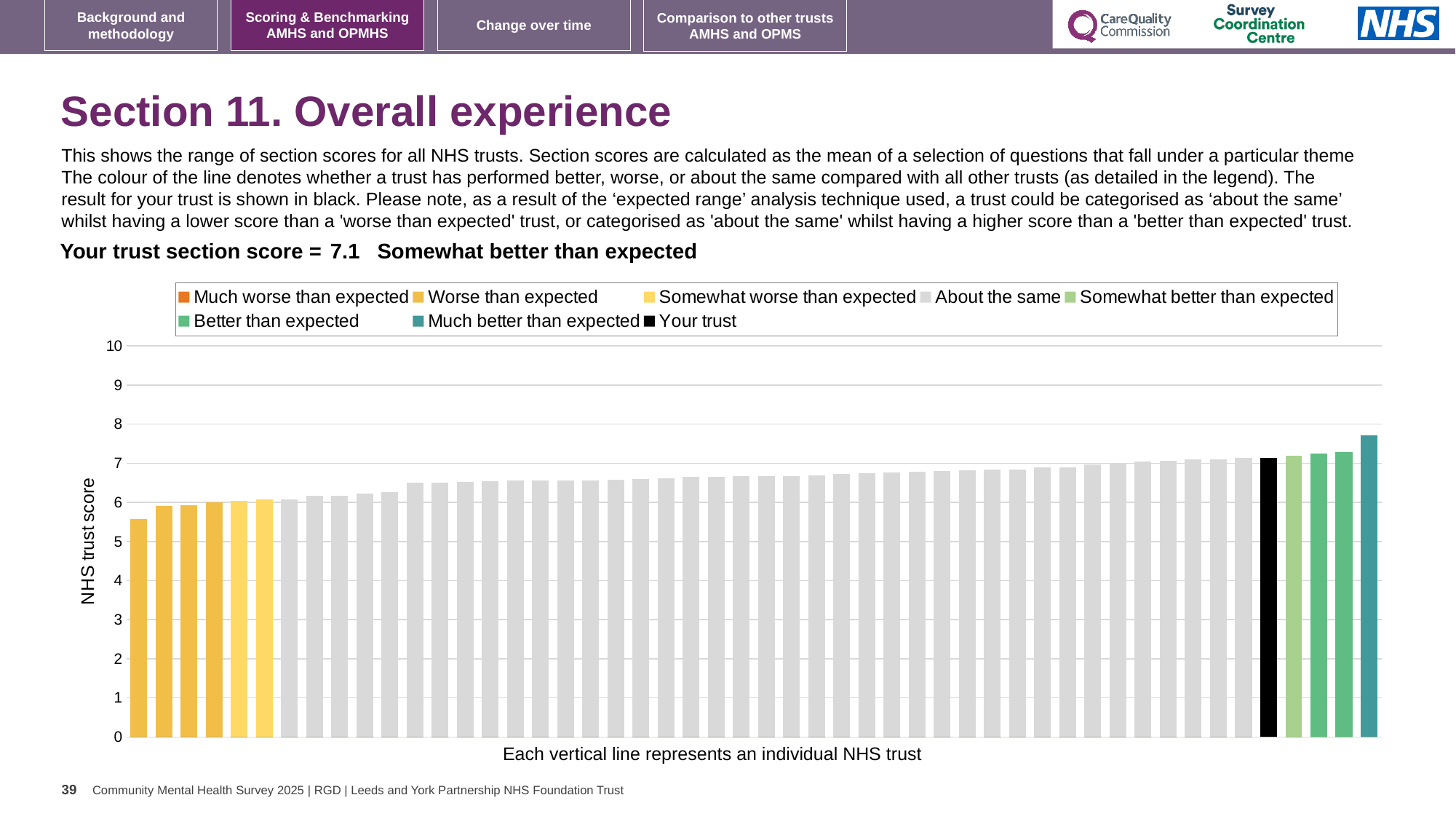
Is the value of the highest bar greater or less than 8? less How many bars are coloured black for 'Your trust'? 1 What is the label on the vertical axis? NHS trust score Is the value for your trust (the black bar) greater or less than 6? greater What kind of chart is shown on the slide? Bar chart How many entries does the chart legend list? 8 What is the section score for your trust (the black bar)? 7.1 Is the value of the lowest bar greater or less than 6? less Do the bar values rise or fall from left to right along the x axis? Rise Which legend category does your trust fall into? Somewhat better than expected Which legend category does the highest bar belong to? Much better than expected